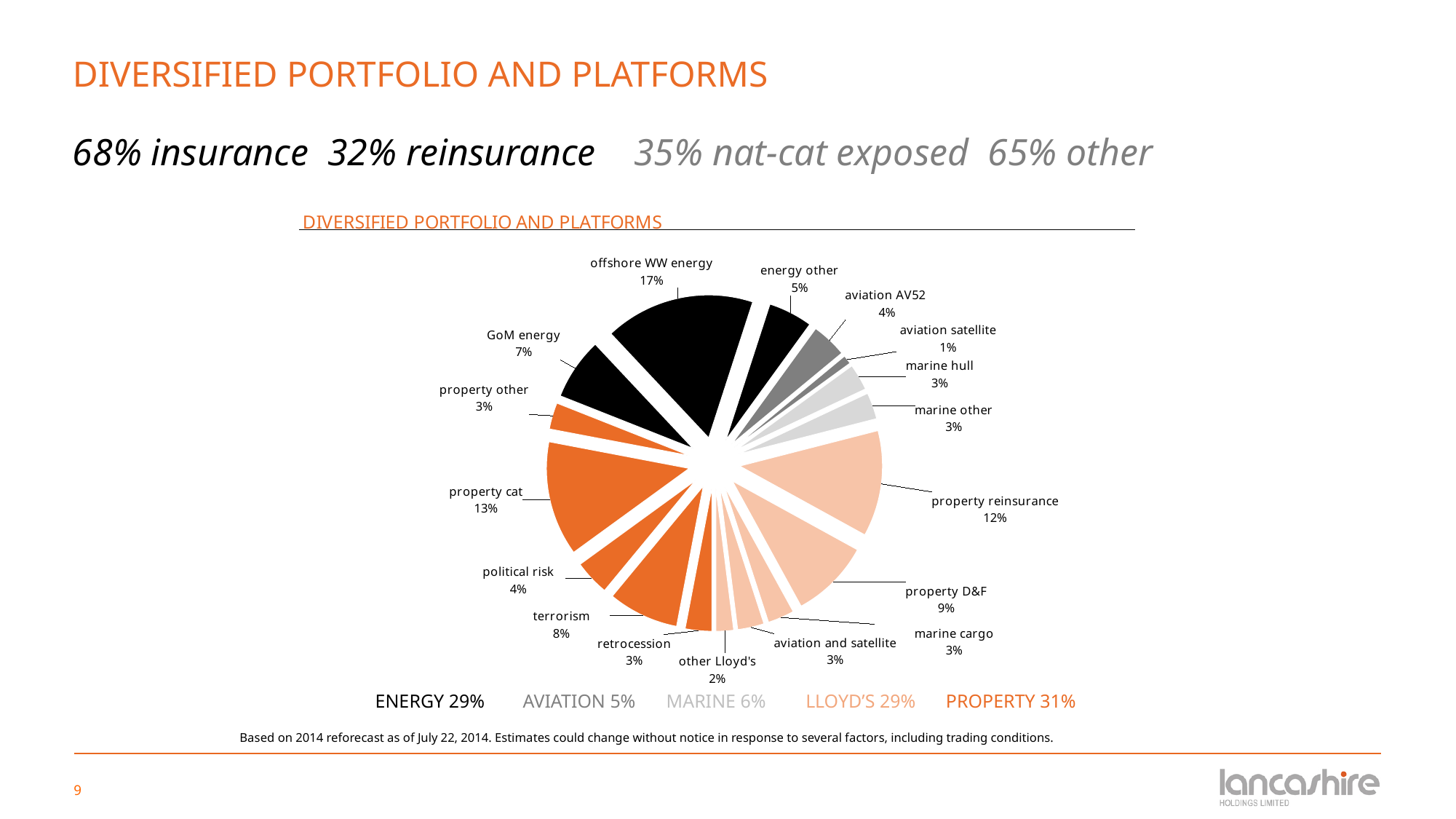
What kind of chart is shown on the slide? pie chart What is the value shown for property reinsurance? 12% What is the value shown for other Lloyd's? 2% Which is larger, GoM energy or energy other? GoM energy Which slice of the pie is the largest? offshore WW energy What is the difference between the property cat share and the property D&F share? 4% What is the value shown for terrorism? 8% What is the title of the chart? DIVERSIFIED PORTFOLIO AND PLATFORMS How many slices does the pie chart have? 17 According to the group labels below the chart, what percentage is PROPERTY? 31% Which slice of the pie is the smallest? aviation satellite What share of the pie does offshore WW energy represent? 17%